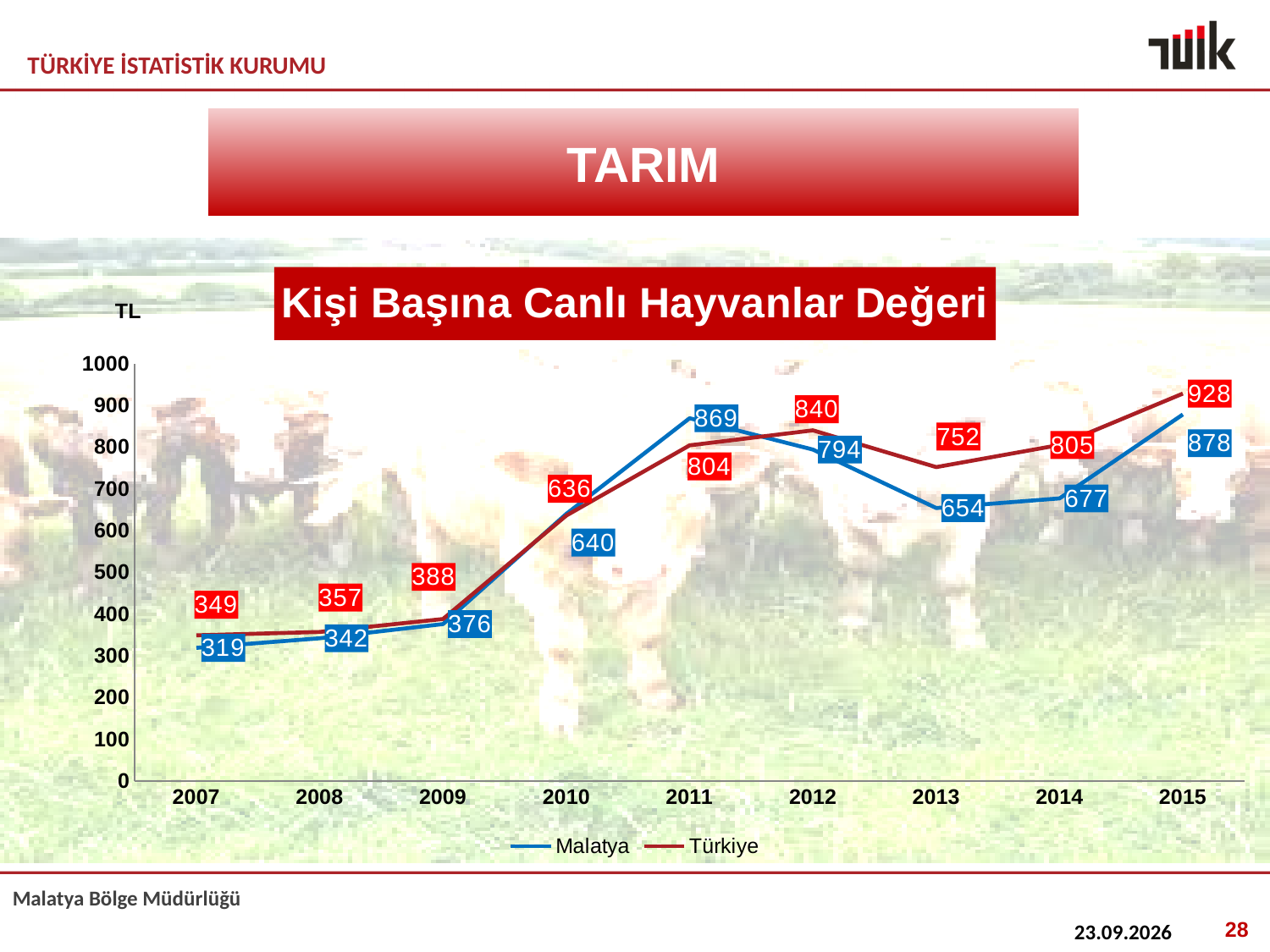
Which series has the larger value in 2011, Malatya or Türkiye? Malatya How many series does the legend list? 2 In which year is the Malatya series lowest? 2007 What is the difference between the Türkiye and Malatya values in 2013? 98 Which series has the larger value in 2012, Malatya or Türkiye? Türkiye What is the value for Türkiye in 2015? 928 How many years are shown on the x axis? 9 What is the value for Malatya in 2007? 319 In which year is the Türkiye series highest? 2015 What is the title of the chart? Kişi Başına Canlı Hayvanlar Değeri What is the value for Malatya in 2011? 869 What kind of chart is shown? line chart